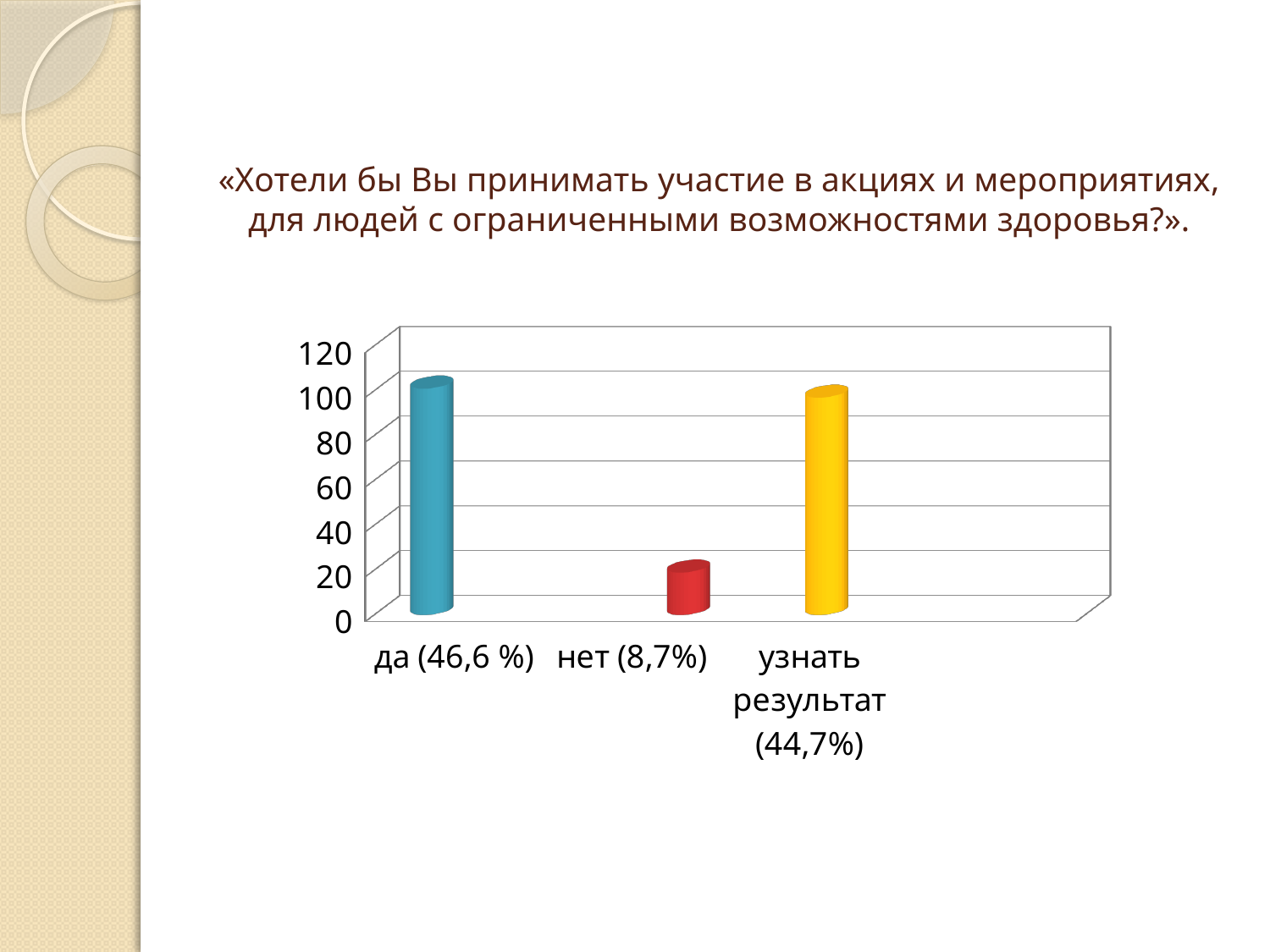
Is the value for "узнать результат (44,7%)" greater or less than 60? greater Is the value for "да (46,6 %)" greater or less than 80? greater What percentage is printed in the category label for "нет"? 8,7% Which bar is taller: "узнать результат (44,7%)" or "нет (8,7%)"? узнать результат (44,7%) What percentage is printed in the category label for "узнать результат"? 44,7% Which category has the lowest bar in the chart? нет (8,7%) Is the value for "нет (8,7%)" greater or less than 40? less What is the highest value shown on the vertical axis of the chart? 120 What percentage is printed in the category label for "да"? 46,6 % What kind of chart is shown on the slide? bar chart Which bar is taller: "да (46,6 %)" or "нет (8,7%)"? да (46,6 %) How many categories are shown on the x axis of the chart? 3